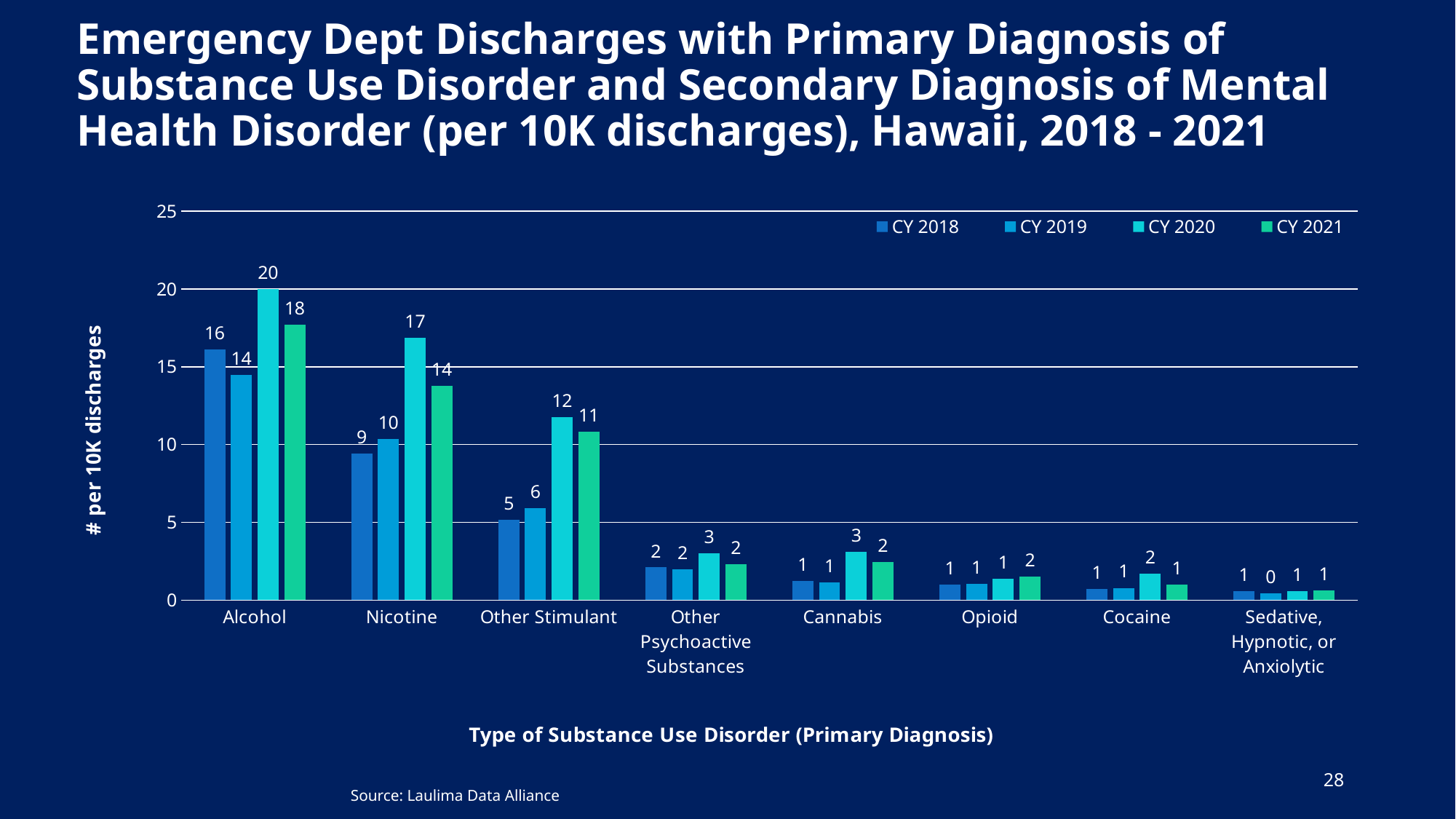
What is the value for Sedative, Hypnotic, or Anxiolytic in CY 2019? 0 Which substance type has the lowest value in CY 2019? Sedative, Hypnotic, or Anxiolytic How many series does the legend list? 4 Which substance type has the highest value in CY 2021? Alcohol Which is larger for Nicotine: the CY 2020 value or the CY 2021 value? CY 2020 What is the value for Alcohol in CY 2020? 20 What is the value for Other Stimulant in CY 2021? 11 What is the label of the y axis? # per 10K discharges What is the difference between the CY 2020 and CY 2018 values for Alcohol? 4 How many substance use disorder categories are shown on the x axis? 8 What kind of chart is shown on the slide? Bar chart What is the value for Nicotine in CY 2019? 10